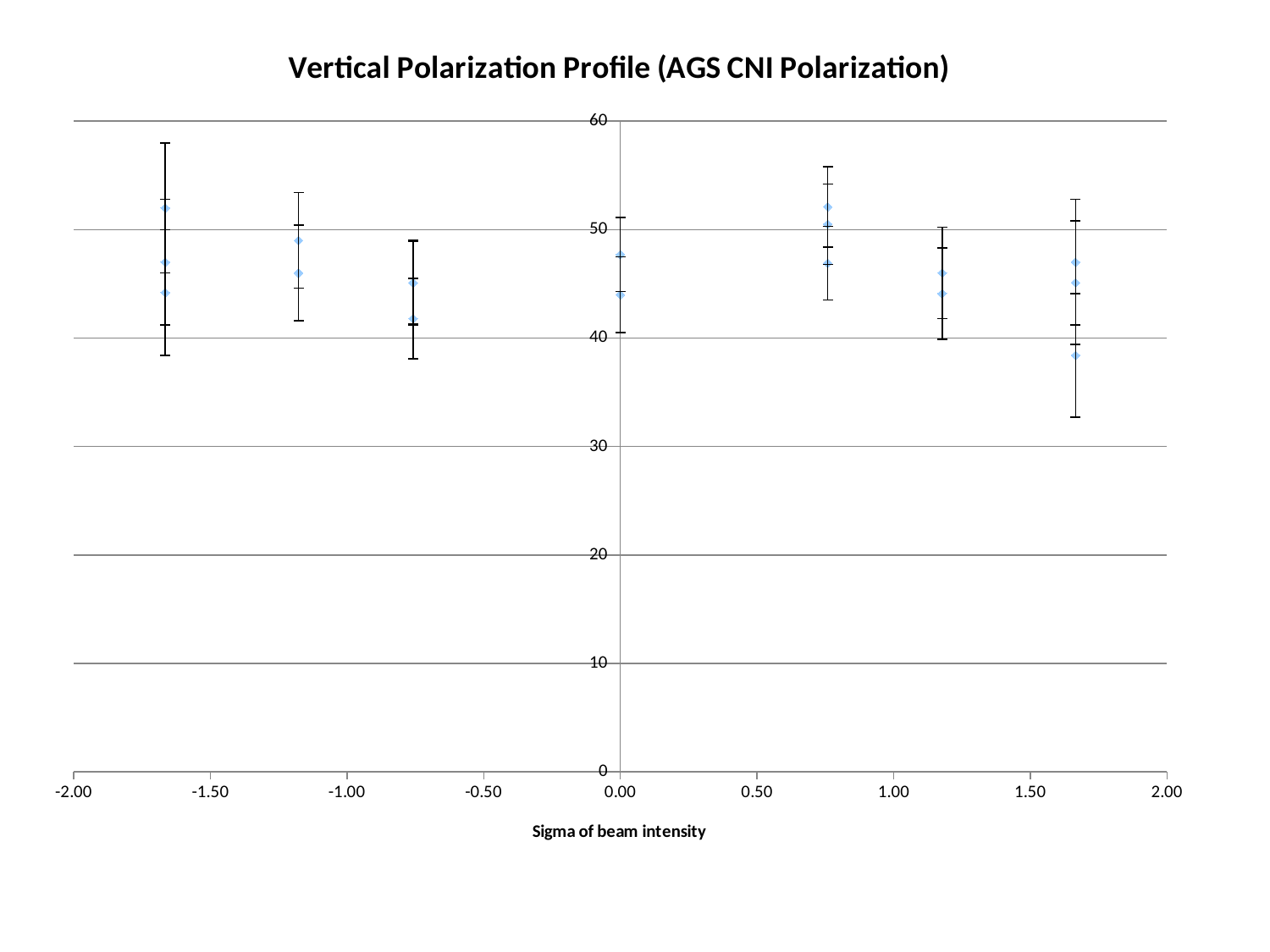
What is the label of the x axis? Sigma of beam intensity What is the title of the chart? Vertical Polarization Profile (AGS CNI Polarization) Are the plotted values at x = 0.00 greater or less than 50? less How many distinct x positions (clusters of points) are plotted on the chart? 7 What kind of chart is shown on the slide? scatter chart Is the highest plotted value at x = 0.75 greater or less than 50? greater Is the highest plotted value at x = -1.67 greater or less than 50? greater What is the maximum value shown on the y axis? 60